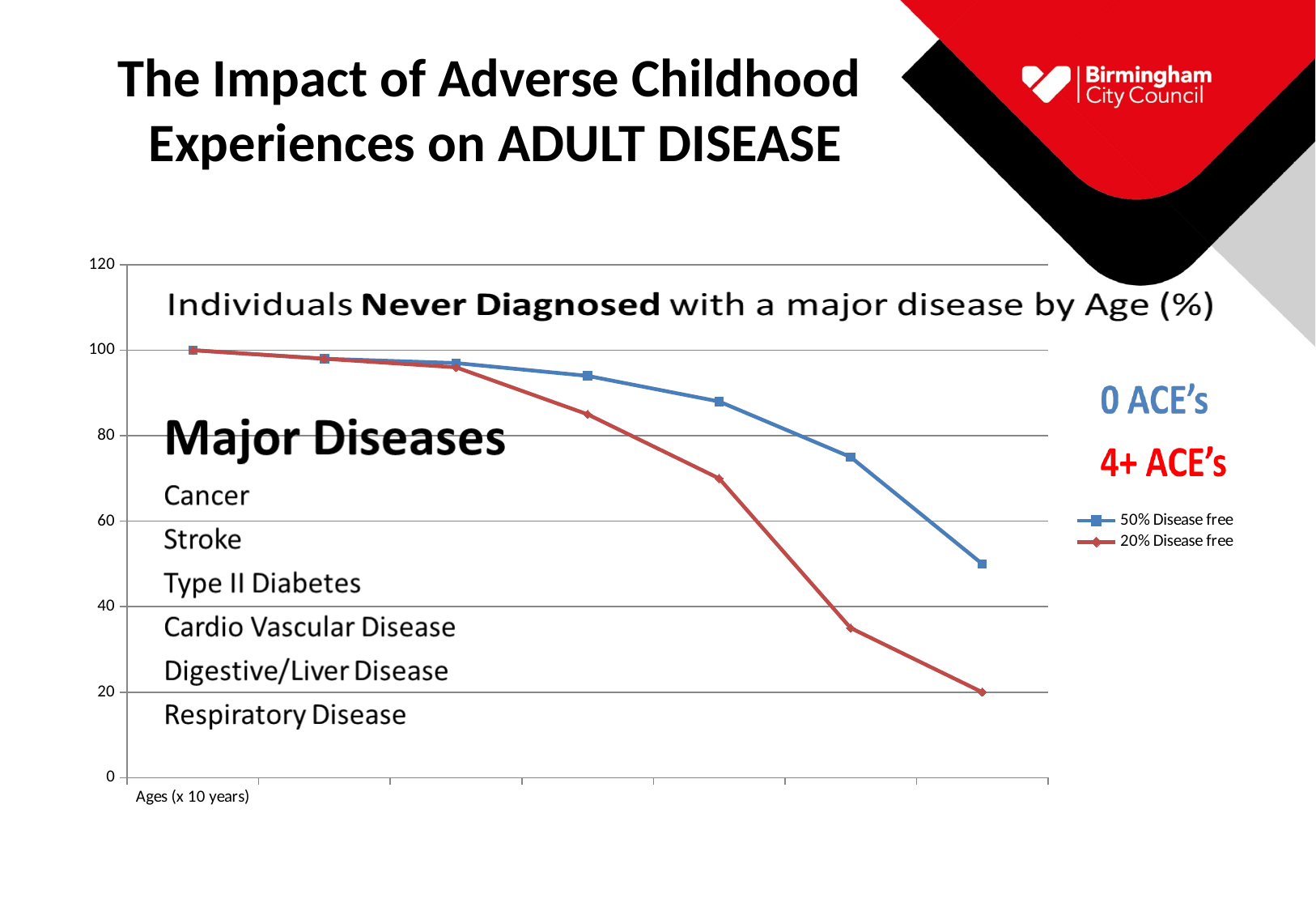
How many series does the chart legend list? 2 Is the value of the sixth point on the red '20% Disease free' line greater or less than 40? less How many data points are plotted on the blue '50% Disease free' line? 7 What is the label of the x axis of the chart? Ages (x 10 years) What kind of chart is shown on the slide? line chart What is the value of the last point on the red '20% Disease free' line? 20 Is the value of the last point on the blue '50% Disease free' line greater or less than 40? greater At the last point on the x axis, which line has the larger value, the blue '50% Disease free' line or the red '20% Disease free' line? 50% Disease free What is the value of the first point on the red '20% Disease free' line? 100 Which colour is used for the '4+ ACE's' line in the chart? red Do the values of the red '20% Disease free' line rise or fall along the x axis? fall Is the value of the sixth point on the blue '50% Disease free' line greater or less than 80? less